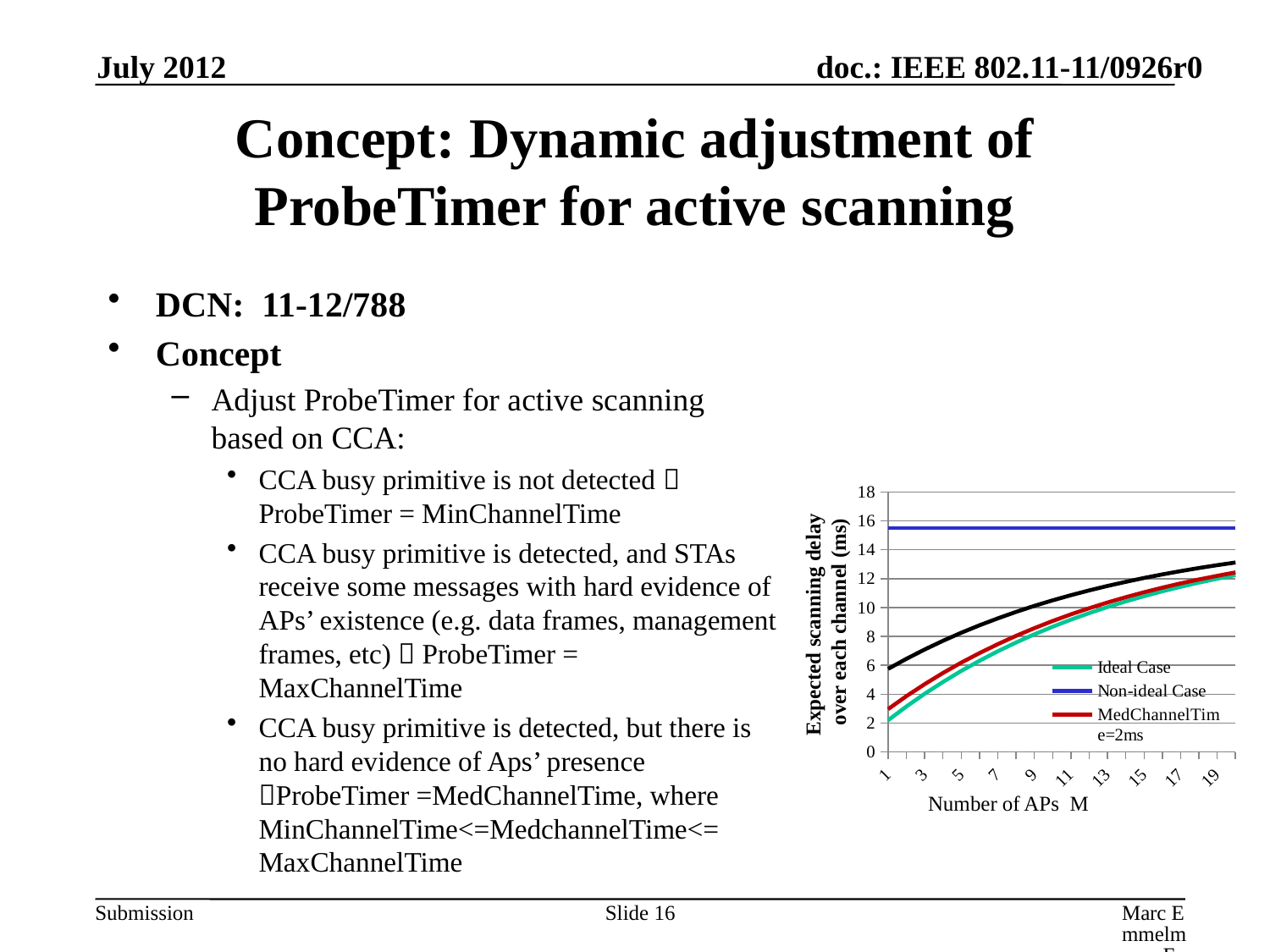
Is the value for the Ideal Case at 1 AP greater or less than 4? less Does the Ideal Case line rise or fall as the number of APs increases? rises At 1 AP, which is larger: the Non-ideal Case or the Ideal Case? Non-ideal Case Which series has the highest value at 1 AP? Non-ideal Case Is the value for the Non-ideal Case at 1 AP greater or less than 14? greater Is the value for MedChannelTime=2ms at 1 AP greater or less than 6? less What is the title of the y axis of the chart? Expected scanning delay over each channel (ms) What is the title of the x axis of the chart? Number of APs M What kind of chart is shown on the slide? line chart How many series does the chart legend list? 3